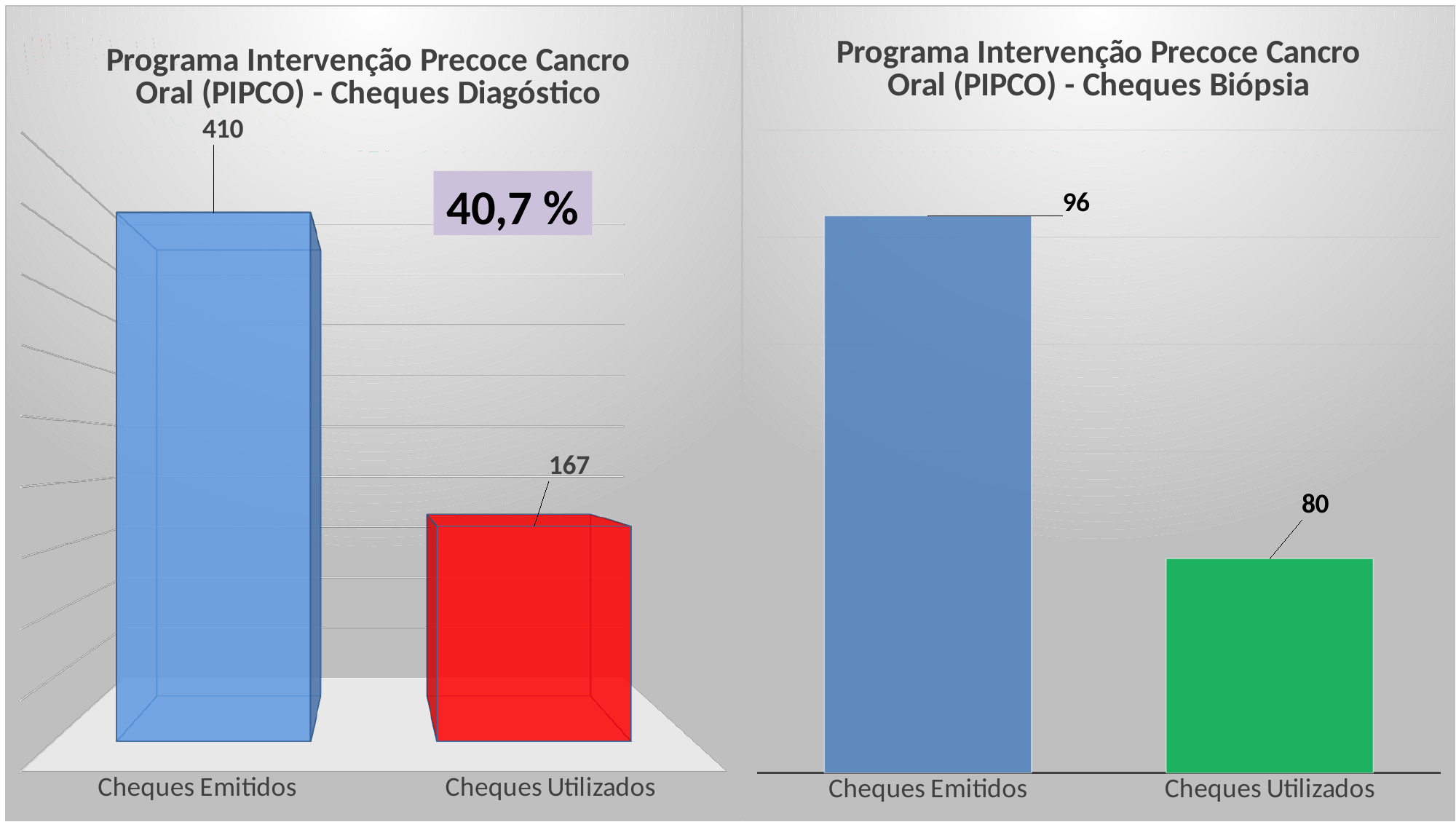
In the 'Cheques Diagóstico' chart, what is the value for Cheques Emitidos? 410 How many categories does the 'Cheques Diagóstico' chart show? 2 In the 'Cheques Biópsia' chart, what is the value for Cheques Emitidos? 96 In the 'Cheques Diagóstico' chart, what is the difference between Cheques Emitidos and Cheques Utilizados? 243 In the 'Cheques Biópsia' chart, which is larger: Cheques Emitidos or Cheques Utilizados? Cheques Emitidos What type of chart is the 'Cheques Biópsia' chart? Bar chart In the 'Cheques Diagóstico' chart, what is the value for Cheques Utilizados? 167 In the 'Cheques Biópsia' chart, what is the difference between Cheques Emitidos and Cheques Utilizados? 16 What percentage is shown in the highlighted box on the 'Cheques Diagóstico' chart? 40,7 % In the 'Cheques Diagóstico' chart, which category has the highest value? Cheques Emitidos In the 'Cheques Biópsia' chart, what is the value for Cheques Utilizados? 80 In the 'Cheques Biópsia' chart, which category has the lowest value? Cheques Utilizados